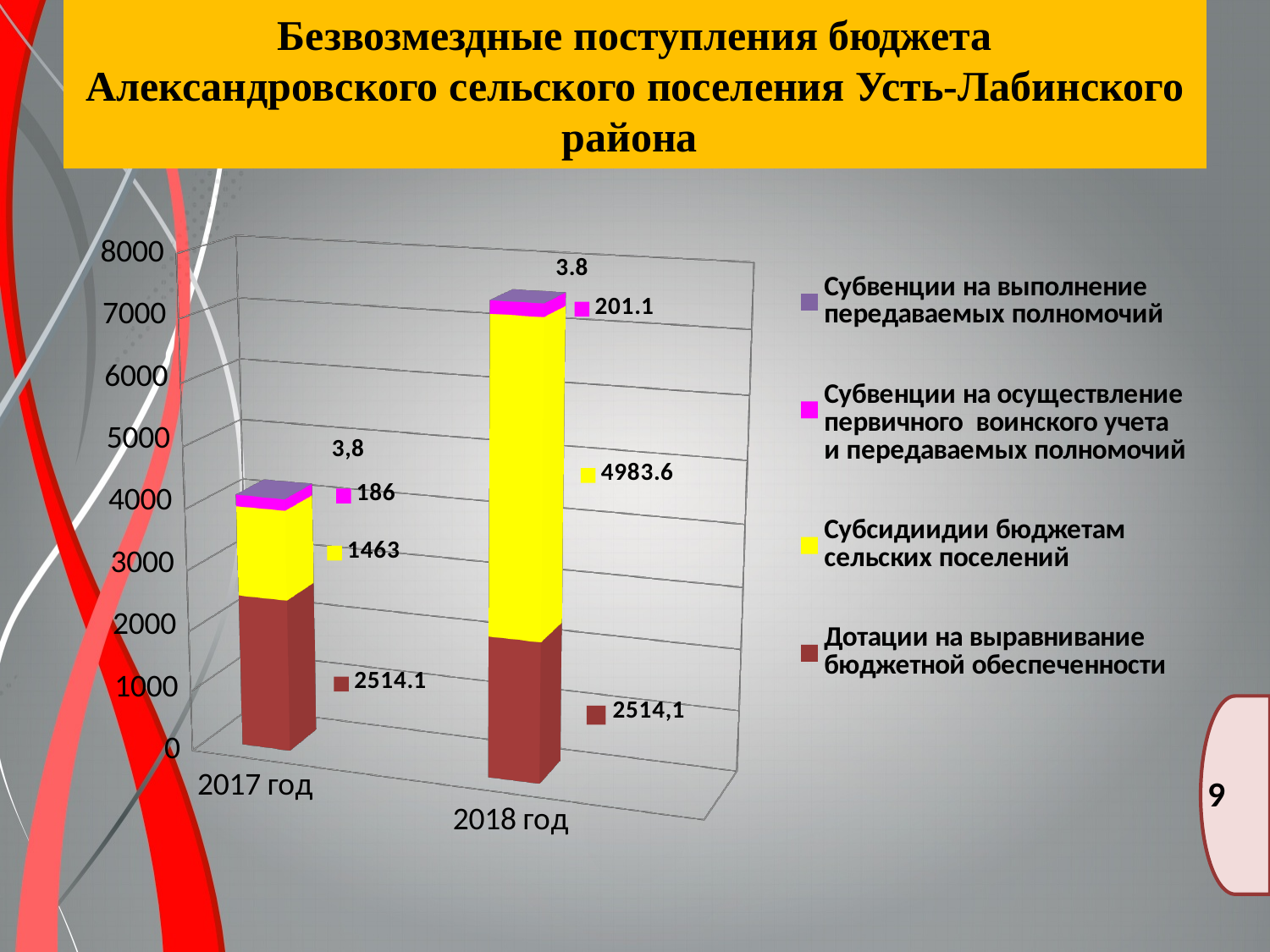
What is the value of 'Субсидиидии бюджетам сельских поселений' for 2018 год? 4983.6 How many categories (years) are shown on the x axis? 2 What is the value of 'Субсидиидии бюджетам сельских поселений' for 2017 год? 1463 Is the total height of the stacked bar for 2018 год greater or less than 7000? greater Which year has the larger value for 'Субвенции на осуществление первичного воинского учета и передаваемых полномочий', 2017 год or 2018 год? 2018 год What is the value of 'Субвенции на выполнение передаваемых полномочий' for 2018 год? 3.8 What is the value of 'Субвенции на осуществление первичного воинского учета и передаваемых полномочий' for 2018 год? 201.1 Which colour represents 'Субсидиидии бюджетам сельских поселений' in the chart? yellow What type of chart is shown on the slide? stacked bar chart How many series does the legend list? 4 By how much did 'Субсидиидии бюджетам сельских поселений' increase from 2017 год to 2018 год? 3520.6 What is the value of 'Дотации на выравнивание бюджетной обеспеченности' for 2017 год? 2514.1